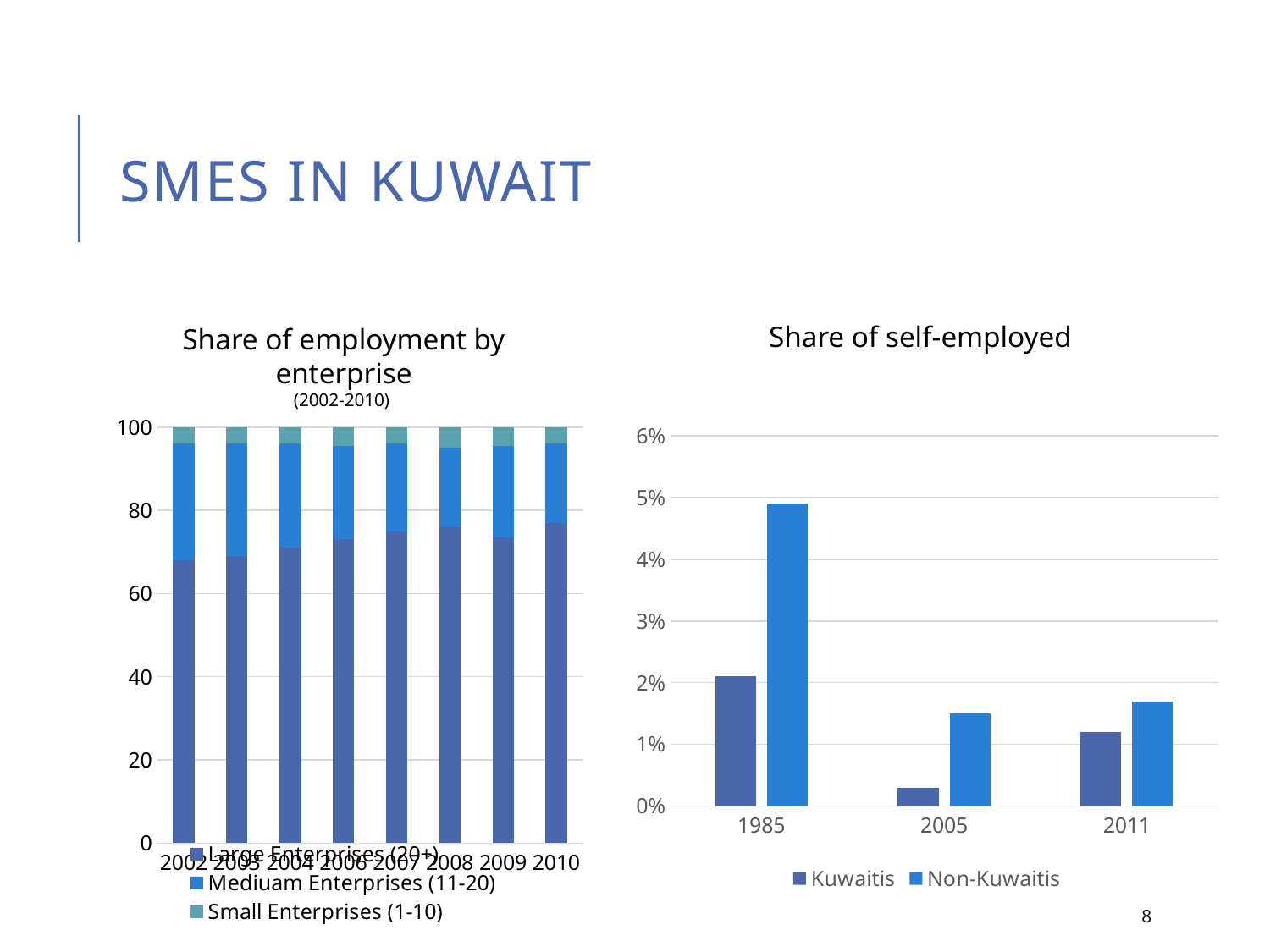
How many series does the legend of the 'Share of employment by enterprise' chart list? 3 In the 'Share of self-employed' chart, which year has the highest Non-Kuwaitis value? 1985 How many series does the legend of the 'Share of self-employed' chart list? 2 In the 'Share of self-employed' chart, is the Non-Kuwaitis value for 1985 greater or less than 4%? greater In the 'Share of employment by enterprise' chart, is the Large Enterprises (20+) value for 2010 greater or less than 60? greater How many stacked bars are shown in the 'Share of employment by enterprise' chart? 8 How many years are shown on the x axis of the 'Share of self-employed' chart? 3 In the 'Share of self-employed' chart, does the Non-Kuwaitis value rise or fall from 1985 to 2005? fall In the 'Share of self-employed' chart, which is larger in 1985: Kuwaitis or Non-Kuwaitis? Non-Kuwaitis What kind of chart is the 'Share of self-employed' chart? bar chart In the 'Share of self-employed' chart, is the Kuwaitis value for 2005 greater or less than 1%? less In the 'Share of self-employed' chart, which year has the lowest Kuwaitis value? 2005